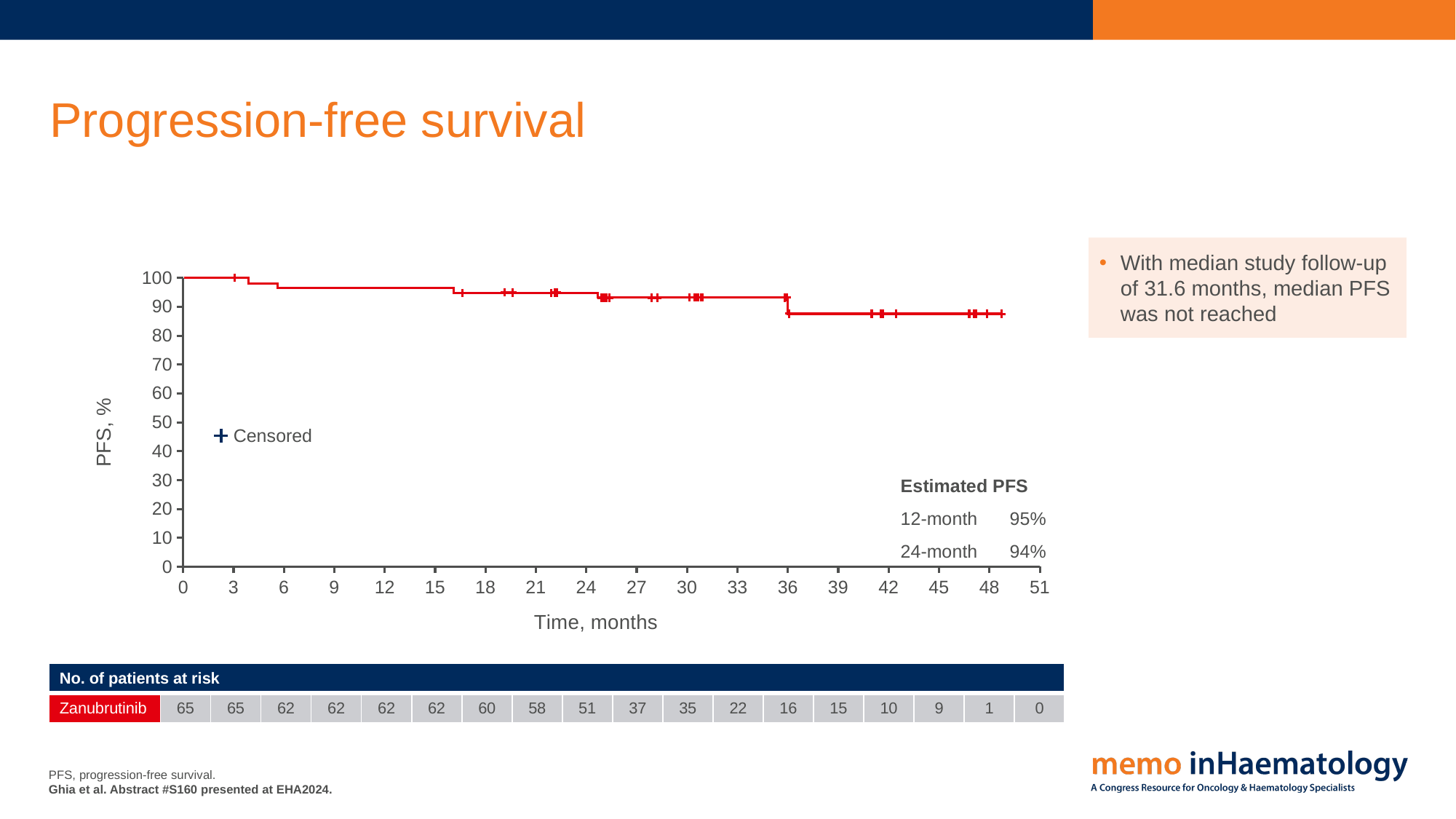
What is the estimated 12-month PFS shown on the chart? 95% Does the PFS curve rise or fall as time in months increases? Fall What is the estimated 24-month PFS shown on the chart? 94% Is the PFS value at 12 months greater or less than 90? greater Which is larger: the estimated 12-month PFS or the estimated 24-month PFS? 12-month PFS Is the PFS value at 42 months greater or less than 80? greater How many patients were at risk at 24 months in the Zanubrutinib row? 51 What is the label of the y axis? PFS, % What is the difference between the number of patients at risk at 0 months and at 27 months? 28 How many patients were at risk at 0 months in the Zanubrutinib row? 65 How many patients were at risk at 36 months in the Zanubrutinib row? 16 What kind of chart is shown on the slide? Line chart (Kaplan-Meier survival curve)